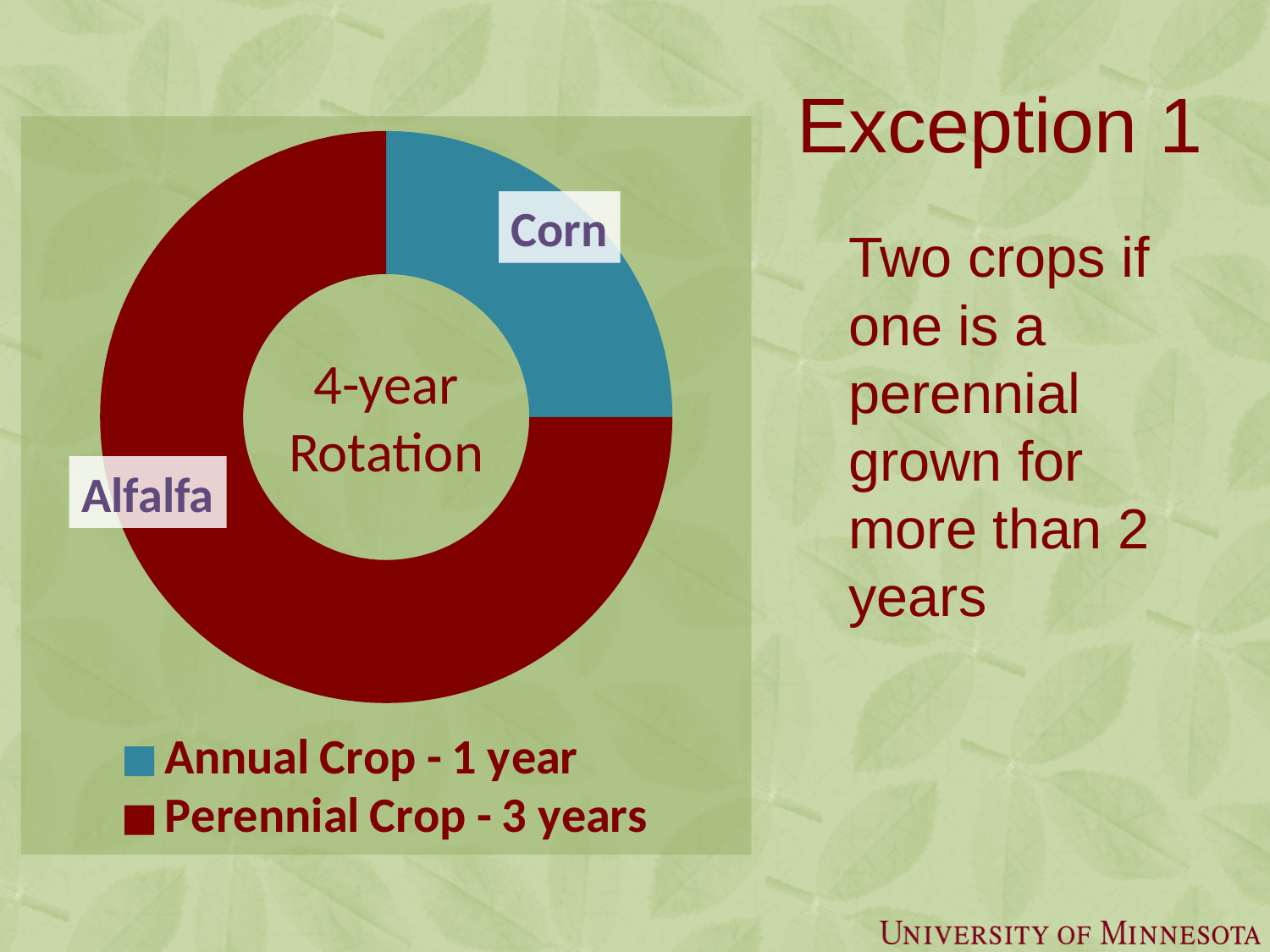
How many slices does the chart have? 2 What kind of chart is shown on the slide? doughnut chart Which crop takes up the smallest share of the rotation chart? Corn Which slice is larger, Corn or Alfalfa? Alfalfa According to the legend, how many years is the annual crop grown? 1 year How many more years is the perennial crop grown than the annual crop? 2 years What text is written in the centre of the doughnut chart? 4-year Rotation According to the legend, how many years is the perennial crop grown? 3 years What share of the 4-year rotation does Corn represent? 25% How many entries does the chart's legend list? 2 Which crop takes up the largest share of the rotation chart? Alfalfa What is the total length of the rotation shown in the chart? 4 years